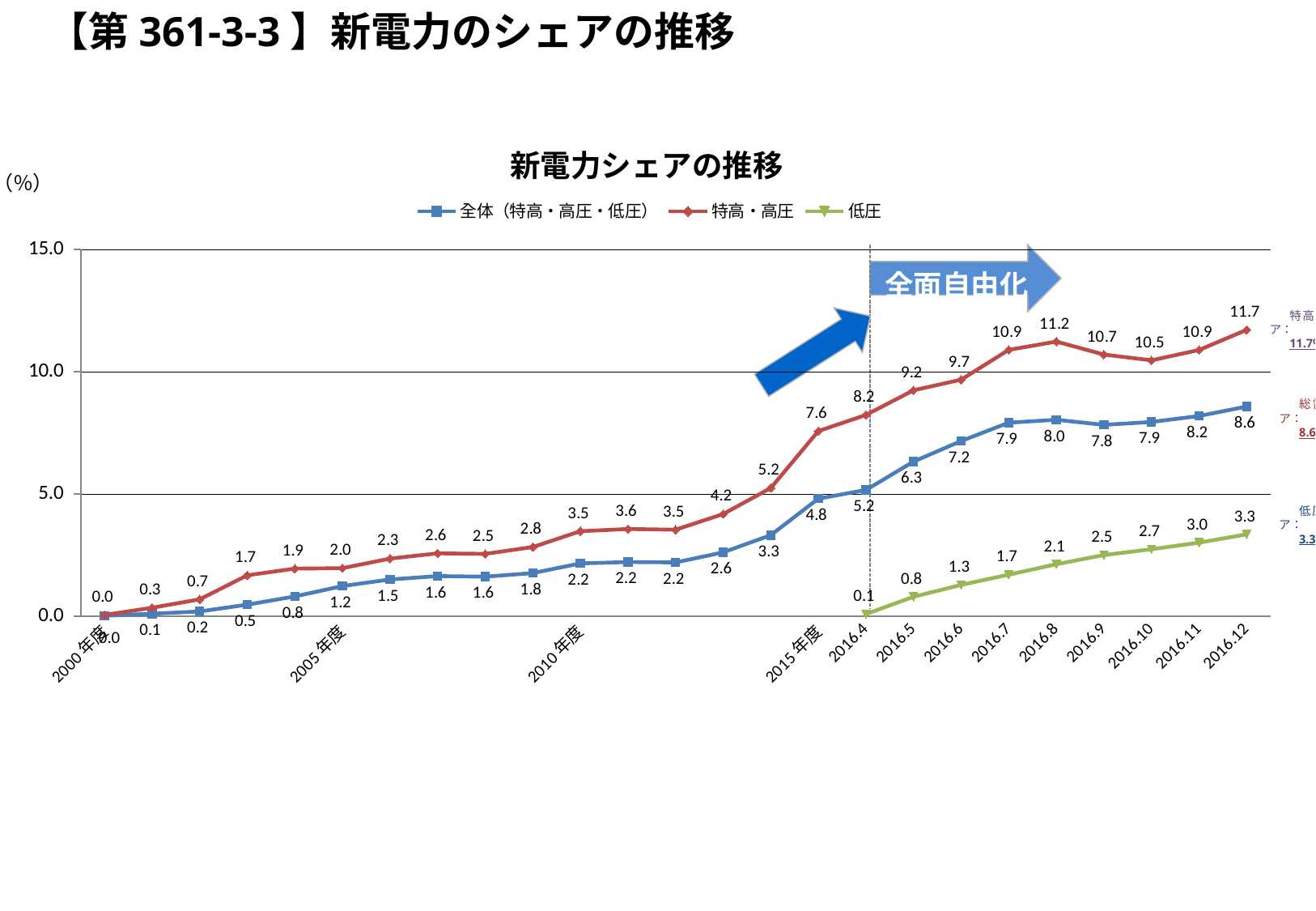
What is the value of 低圧 in 2016.4? 0.1 What is the value of 全体（特高・高圧・低圧） in 2010年度? 2.2 Does the 低圧 series rise or fall from 2016.4 to 2016.12? rise How many series does the legend list? 3 What is the value of 全体（特高・高圧・低圧） in 2016.12? 8.6 Which is larger in 2016.8: 特高・高圧 or 低圧? 特高・高圧 What is the difference between 特高・高圧 and 全体（特高・高圧・低圧） in 2016.12? 3.1 What is the title of the chart? 新電力シェアの推移 What is the value of 特高・高圧 in 2016.12? 11.7 What is the value of 特高・高圧 in 2015年度? 7.6 What type of chart is shown on the slide? line chart At which x-axis point does 特高・高圧 reach its highest value? 2016.12